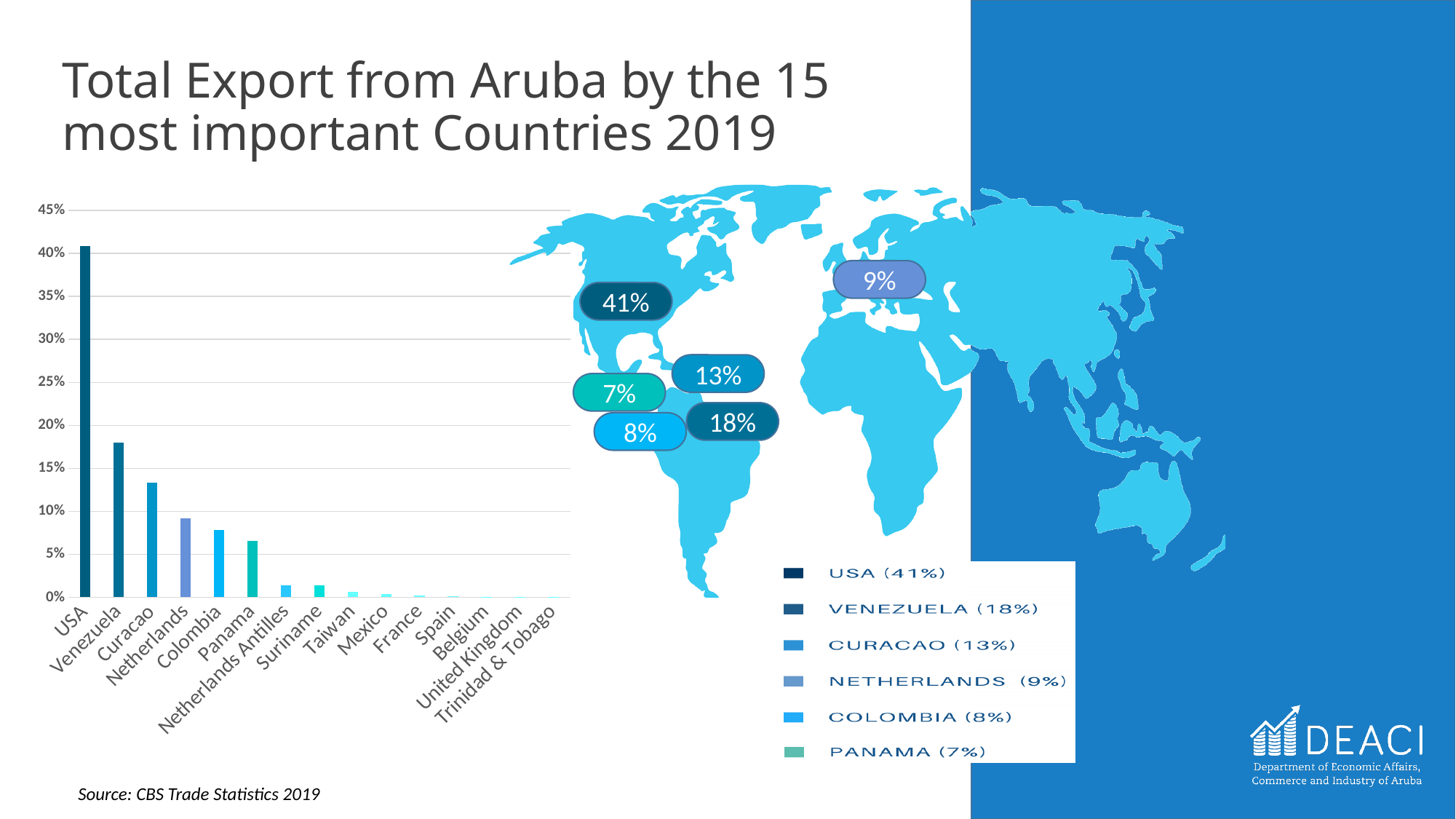
Is the value for USA in the bar chart greater or less than 35%? greater How many countries are shown on the x axis of the bar chart? 15 Which country has the highest export share in the bar chart? USA Is the value for Venezuela in the bar chart greater or less than 20%? less In the bar chart, which is larger, the value for Venezuela or the value for Curacao? Venezuela What type of chart is shown on the left of the slide? bar chart Is the value for Curacao in the bar chart greater or less than 10%? greater According to the map legend, what is the difference between the export shares of USA (41%) and Venezuela (18%)? 23% Do the values in the bar chart rise or fall from left to right along the x axis? fall How many countries are listed in the map legend? 6 According to the map legend, what is the export share for Curacao? 13%